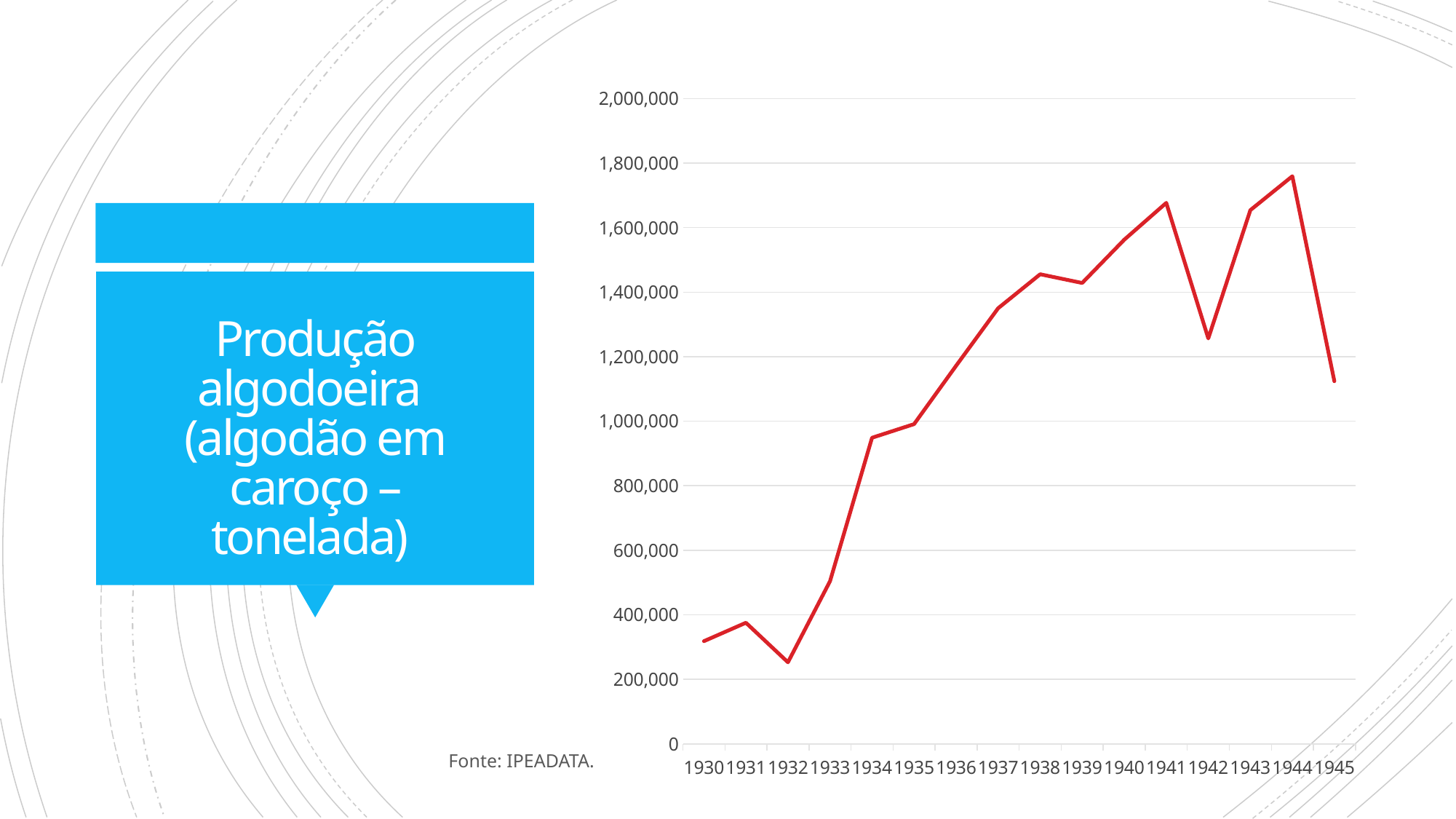
Is the value for 1942 greater or less than 1,400,000? less How many years are plotted on the x axis? 16 What source is cited for the chart data? IPEADATA Is the value for 1934 greater or less than 1,000,000? less Which year has the highest value on the chart? 1944 Is the value for 1932 greater or less than 400,000? less Which is larger, the value for 1941 or the value for 1942? 1941 What kind of chart is shown on the slide? line chart Does the line rise or fall between 1944 and 1945? fall Which year has the lowest value on the chart? 1932